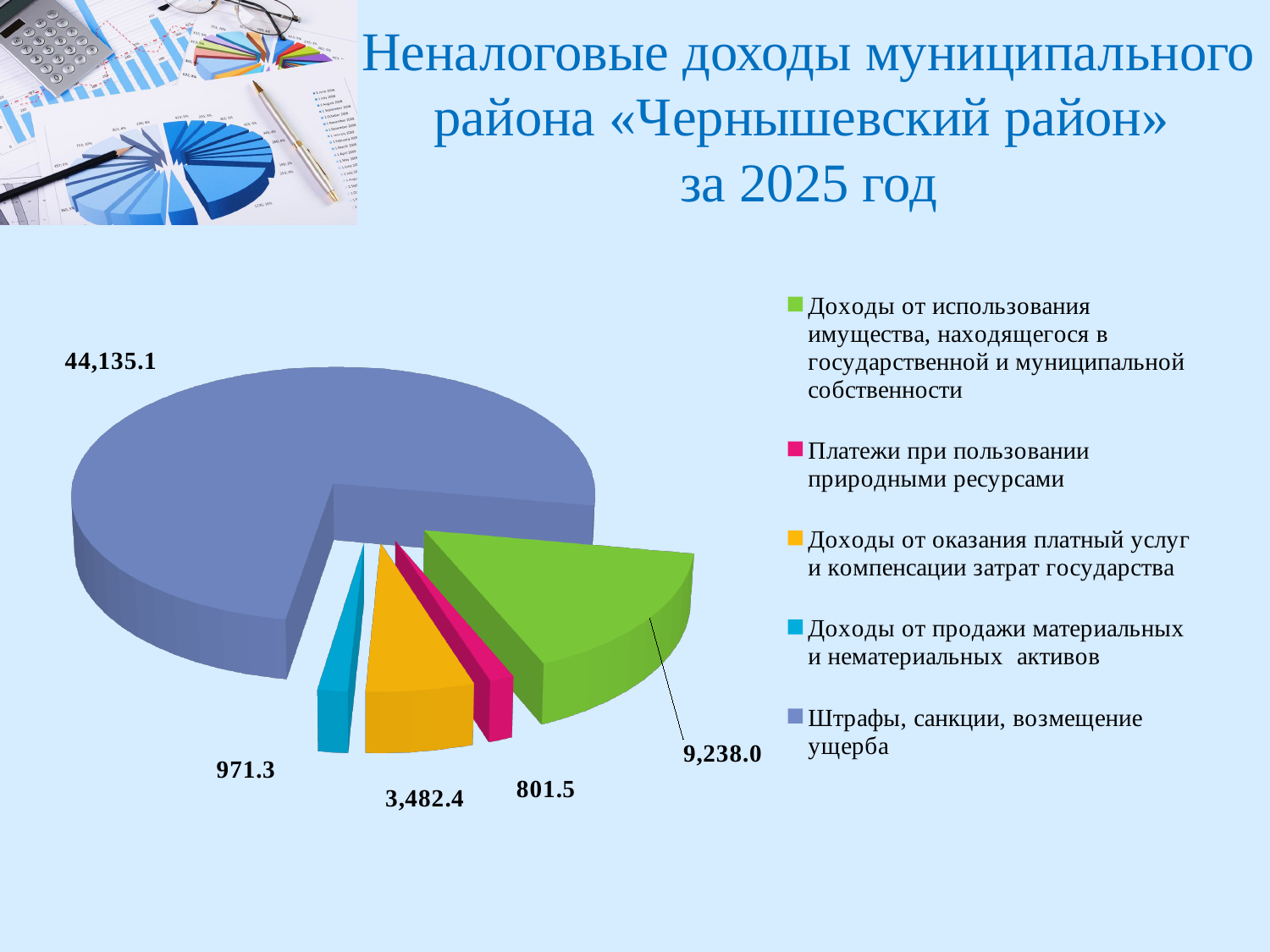
Which is larger: the value for «Доходы от оказания платный услуг и компенсации затрат государства» or the value for «Доходы от продажи материальных и нематериальных активов»? Доходы от оказания платный услуг и компенсации затрат государства What type of chart is shown on the slide? pie chart What is the value for «Платежи при пользовании природными ресурсами»? 801.5 What is the value for «Доходы от оказания платный услуг и компенсации затрат государства»? 3,482.4 What is the value for «Доходы от продажи материальных и нематериальных активов»? 971.3 What is the value for «Доходы от использования имущества, находящегося в государственной и муниципальной собственности»? 9,238.0 Which category has the largest value in the pie chart? Штрафы, санкции, возмещение ущерба What is the difference between the values for «Штрафы, санкции, возмещение ущерба» and «Доходы от использования имущества, находящегося в государственной и муниципальной собственности»? 34,897.1 How many slices does the pie chart have? 5 What is the value for «Штрафы, санкции, возмещение ущерба»? 44,135.1 Which category has the smallest value in the pie chart? Платежи при пользовании природными ресурсами How many entries does the legend of the pie chart list? 5